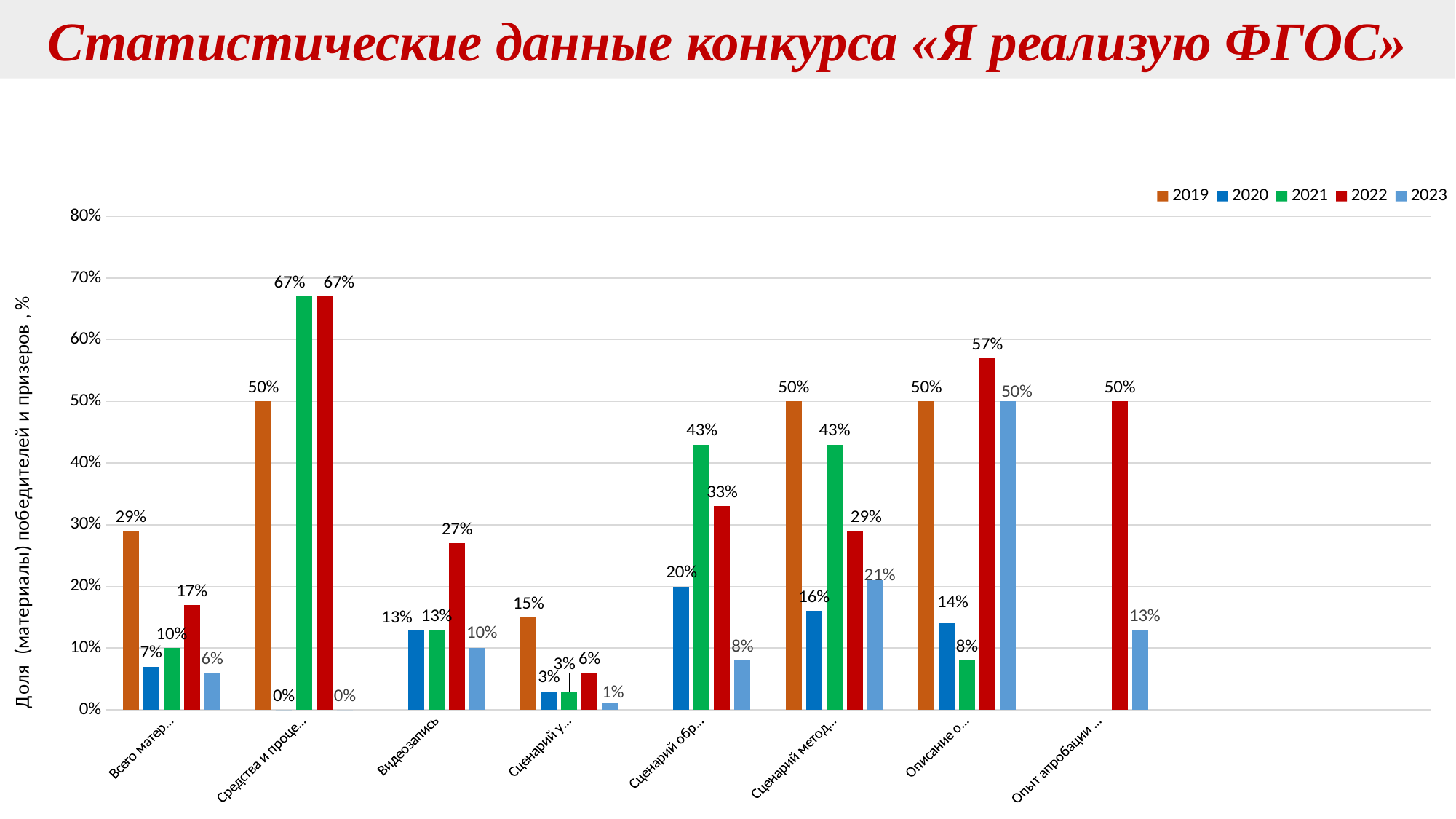
What is the value for 2022 in the "Видеозапись" category? 27% What is the value for 2023 in the "Видеозапись" category? 10% What years are listed in the legend? 2019, 2020, 2021, 2022, 2023 Which year has the highest value in the "Видеозапись" category? 2022 In the "Видеозапись" category, which is larger: the 2020 value or the 2022 value? 2022 What is the difference between the 2022 and 2023 values in the "Видеозапись" category? 17% What is the value for 2022 in the "Опыт апробации ..." category? 50% How many categories are shown along the x axis? 8 What type of chart is shown on the slide? bar chart How many series does the legend list? 5 What is the difference between the 2022 and 2023 values in the "Опыт апробации ..." category? 37% Is the 2022 value for "Видеозапись" greater or less than 20%? greater